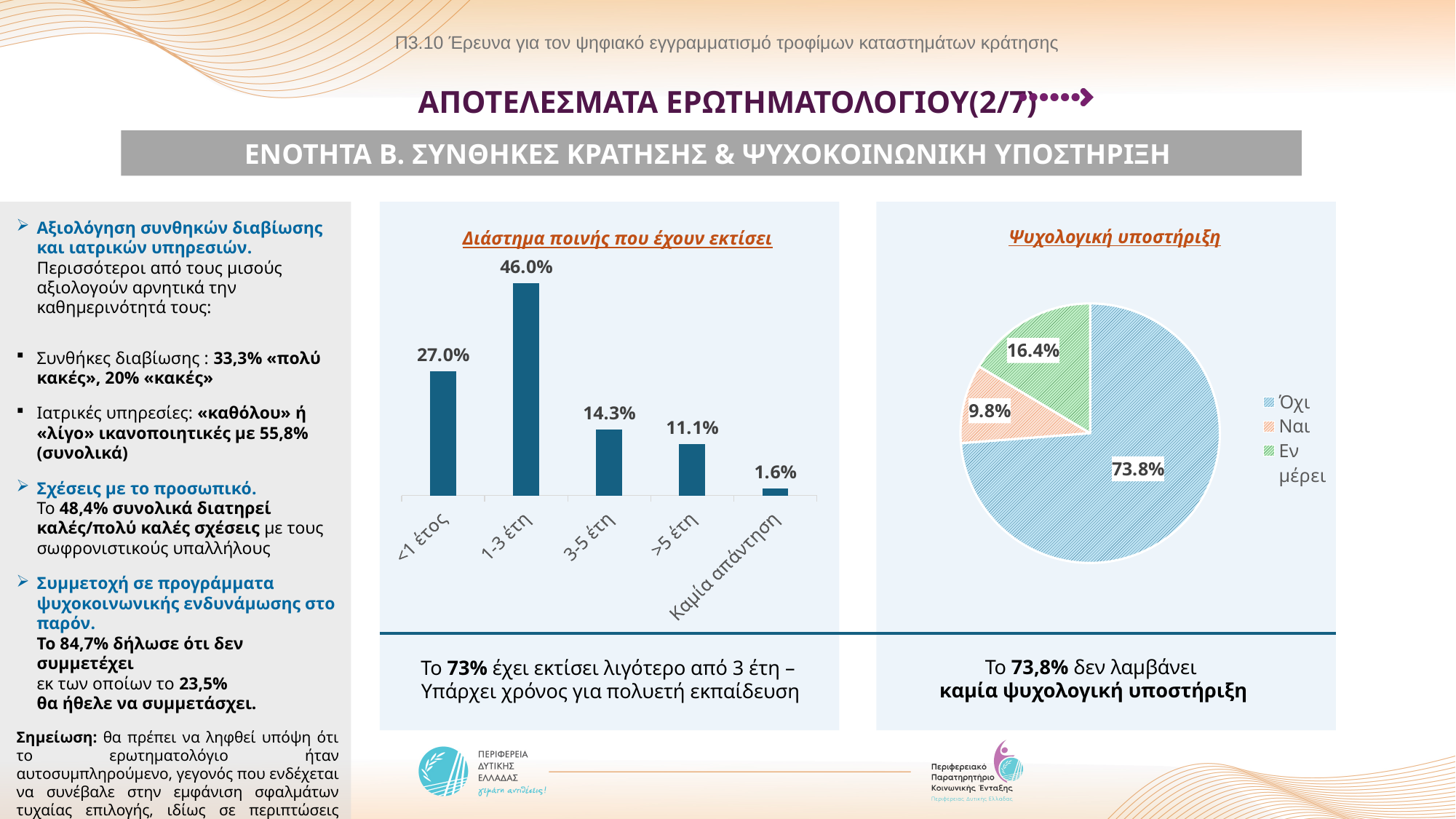
How many categories are shown in the chart titled "Διάστημα ποινής που έχουν εκτίσει"? 5 In the chart titled "Διάστημα ποινής που έχουν εκτίσει", what is the value for "<1 έτος"? 27.0% In the chart titled "Διάστημα ποινής που έχουν εκτίσει", which category has the highest value? 1-3 έτη In the chart titled "Διάστημα ποινής που έχουν εκτίσει", which category has the lowest value? Καμία απάντηση How many entries does the legend of the chart titled "Ψυχολογική υποστήριξη" list? 3 In the chart titled "Διάστημα ποινής που έχουν εκτίσει", what is the value for "1-3 έτη"? 46.0% In the chart titled "Ψυχολογική υποστήριξη", which slice is the smallest? Ναι In the chart titled "Διάστημα ποινής που έχουν εκτίσει", which is larger: the value for "<1 έτος" or the value for "3-5 έτη"? <1 έτος In the chart titled "Διάστημα ποινής που έχουν εκτίσει", what is the difference between the values for "3-5 έτη" and ">5 έτη"? 3.2% In the chart titled "Ψυχολογική υποστήριξη", what is the value for "Ναι"? 9.8% What kind of chart is the one titled "Διάστημα ποινής που έχουν εκτίσει"? Bar chart In the chart titled "Ψυχολογική υποστήριξη", what is the share for "Όχι"? 73.8%